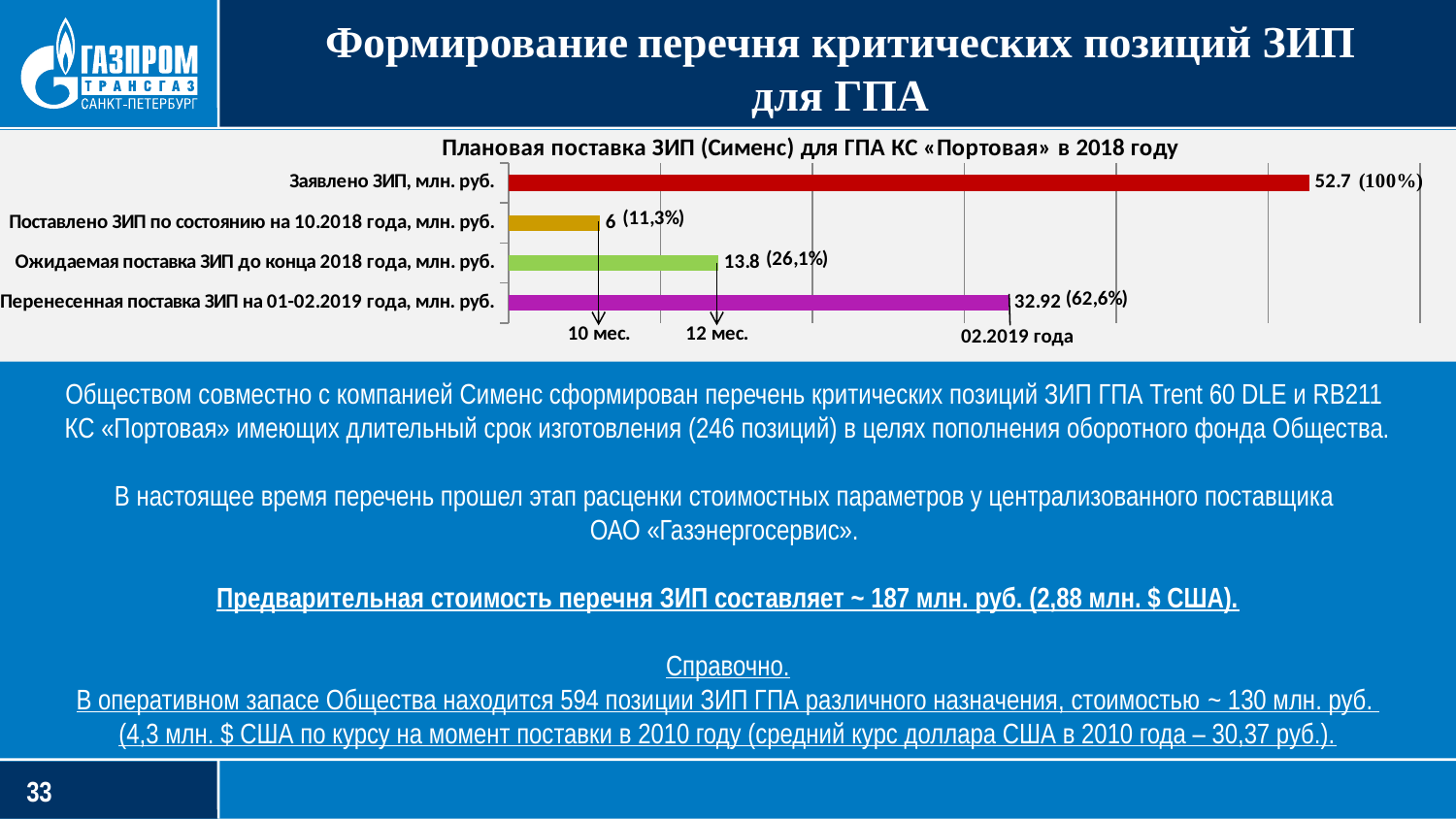
What is the value for «Ожидаемая поставка ЗИП до конца 2018 года, млн. руб.»? 13.8 (26,1%) What is the value for «Заявлено ЗИП, млн. руб.»? 52.7 (100%) What is the value for «Перенесенная поставка ЗИП на 01-02.2019 года, млн. руб.»? 32.92 (62,6%) Which category has the lowest value? Поставлено ЗИП по состоянию на 10.2018 года, млн. руб. What is the title of the chart? Плановая поставка ЗИП (Сименс) для ГПА КС «Портовая» в 2018 году What type of chart is shown on the slide? Bar chart What is the difference in млн. руб. between «Ожидаемая поставка ЗИП до конца 2018 года» and «Поставлено ЗИП по состоянию на 10.2018 года»? 7.8 How many categories are shown in the chart? 4 Which category has the highest value? Заявлено ЗИП, млн. руб. What is the difference in млн. руб. between «Заявлено ЗИП» and «Перенесенная поставка ЗИП на 01-02.2019 года»? 19.78 What is the value for «Поставлено ЗИП по состоянию на 10.2018 года, млн. руб.»? 6 (11,3%) Which is larger: «Ожидаемая поставка ЗИП до конца 2018 года» or «Перенесенная поставка ЗИП на 01-02.2019 года»? Перенесенная поставка ЗИП на 01-02.2019 года